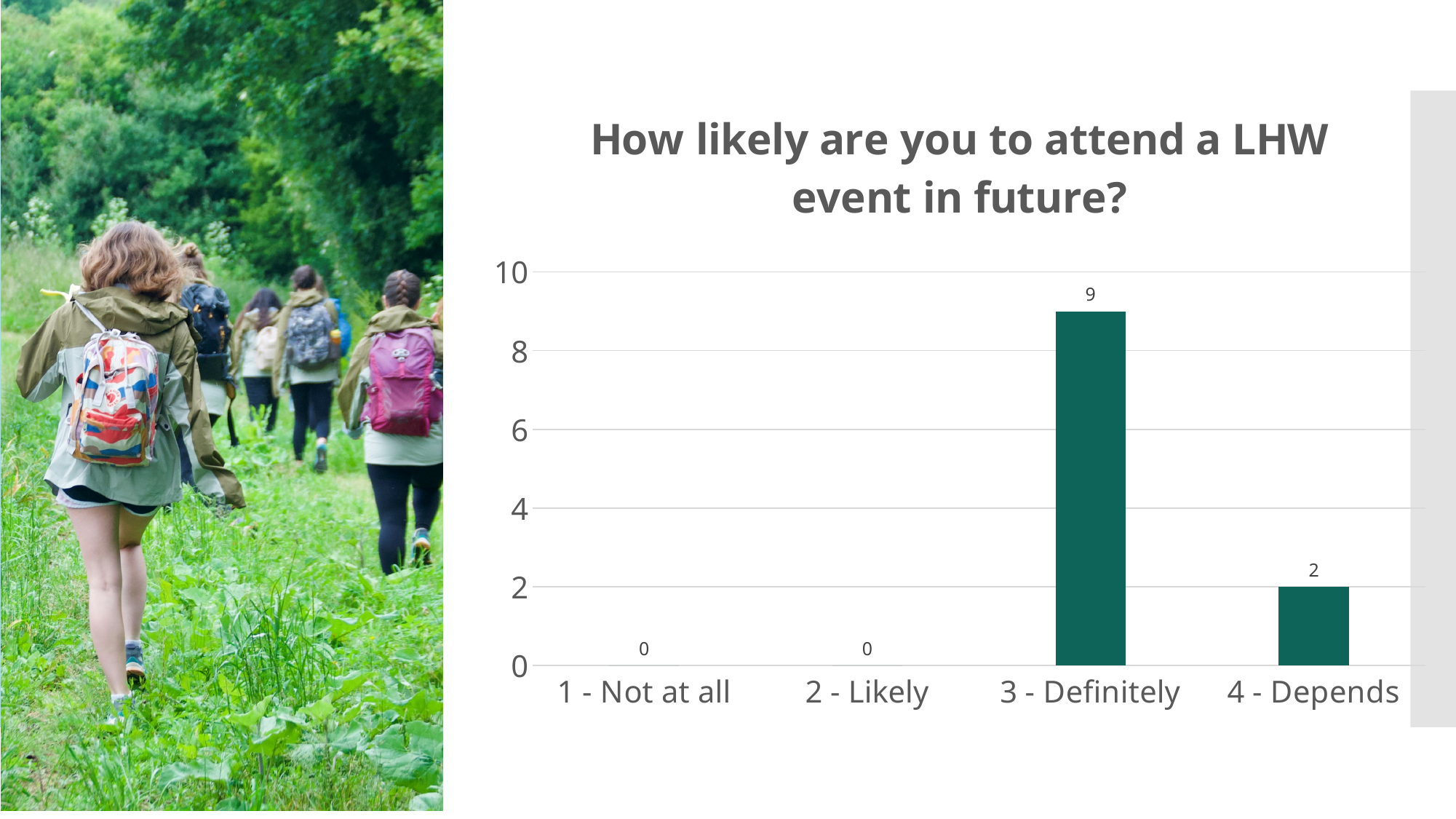
Is the value for "3 - Definitely" greater or less than 8? greater What kind of chart is shown on the slide? bar chart What is the value for "3 - Definitely"? 9 What is the value for "2 - Likely"? 0 What is the title of the chart? How likely are you to attend a LHW event in future? What is the difference between the values for "3 - Definitely" and "4 - Depends"? 7 What is the value for "1 - Not at all"? 0 What is the value for "4 - Depends"? 2 Which is larger, the value for "3 - Definitely" or the value for "4 - Depends"? 3 - Definitely Which category has the highest value? 3 - Definitely What is the highest value shown on the y axis? 10 How many categories are shown on the x axis? 4